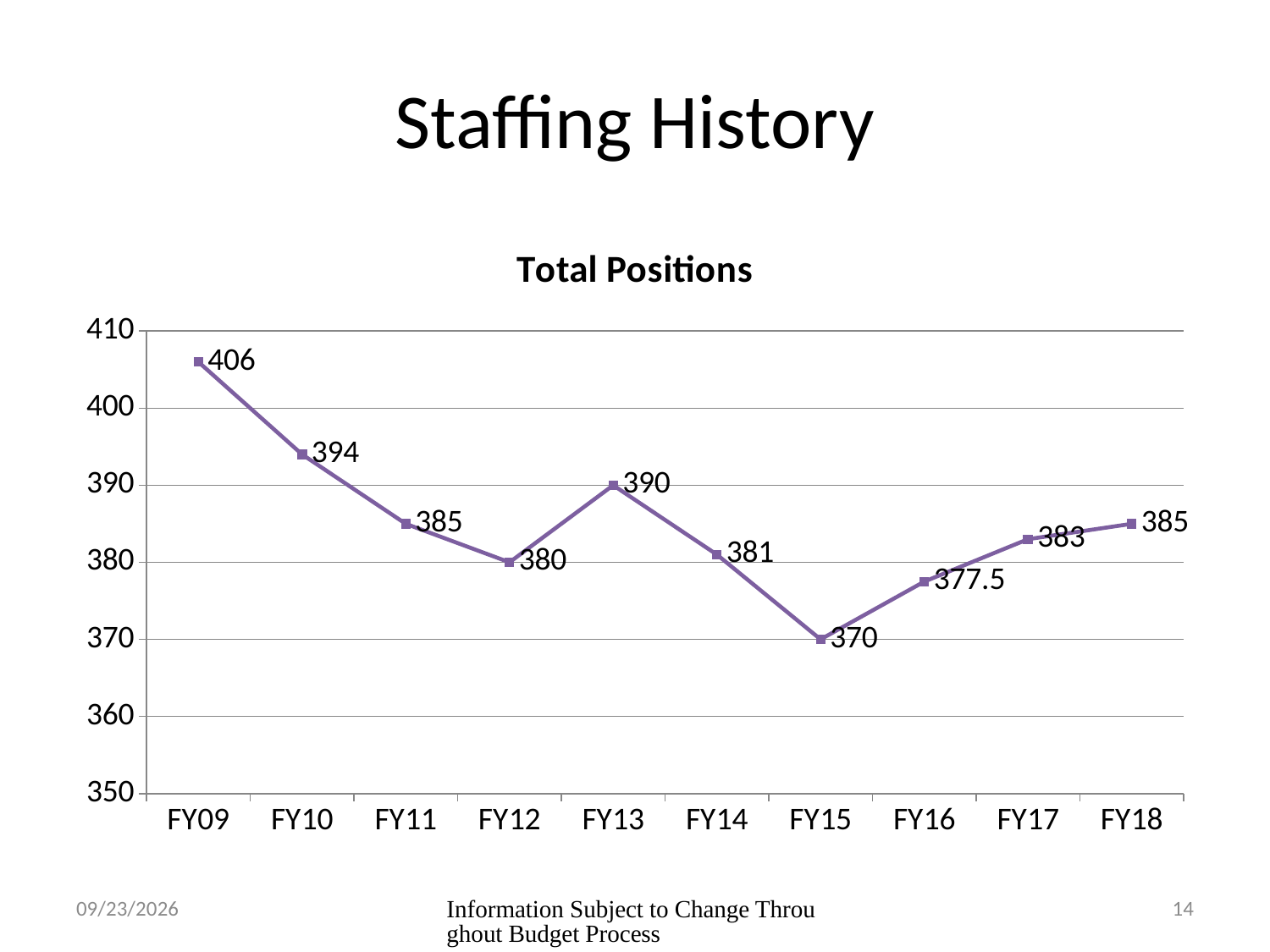
What is the value for FY09 in the Total Positions chart? 406 Which is larger in the Total Positions chart, the value for FY10 or the value for FY13? FY10 Do the values in the Total Positions chart rise or fall from FY15 to FY18? rise Which fiscal year has the highest value in the Total Positions chart? FY09 What kind of chart is the Total Positions chart? line chart Which fiscal year has the lowest value in the Total Positions chart? FY15 What is the value for FY16 in the Total Positions chart? 377.5 What is the value for FY13 in the Total Positions chart? 390 Is the value for FY14 in the Total Positions chart greater or less than 390? less How many fiscal years are plotted in the Total Positions chart? 10 What is the difference between the FY18 and FY17 values in the Total Positions chart? 2 What is the difference between the FY09 and FY15 values in the Total Positions chart? 36